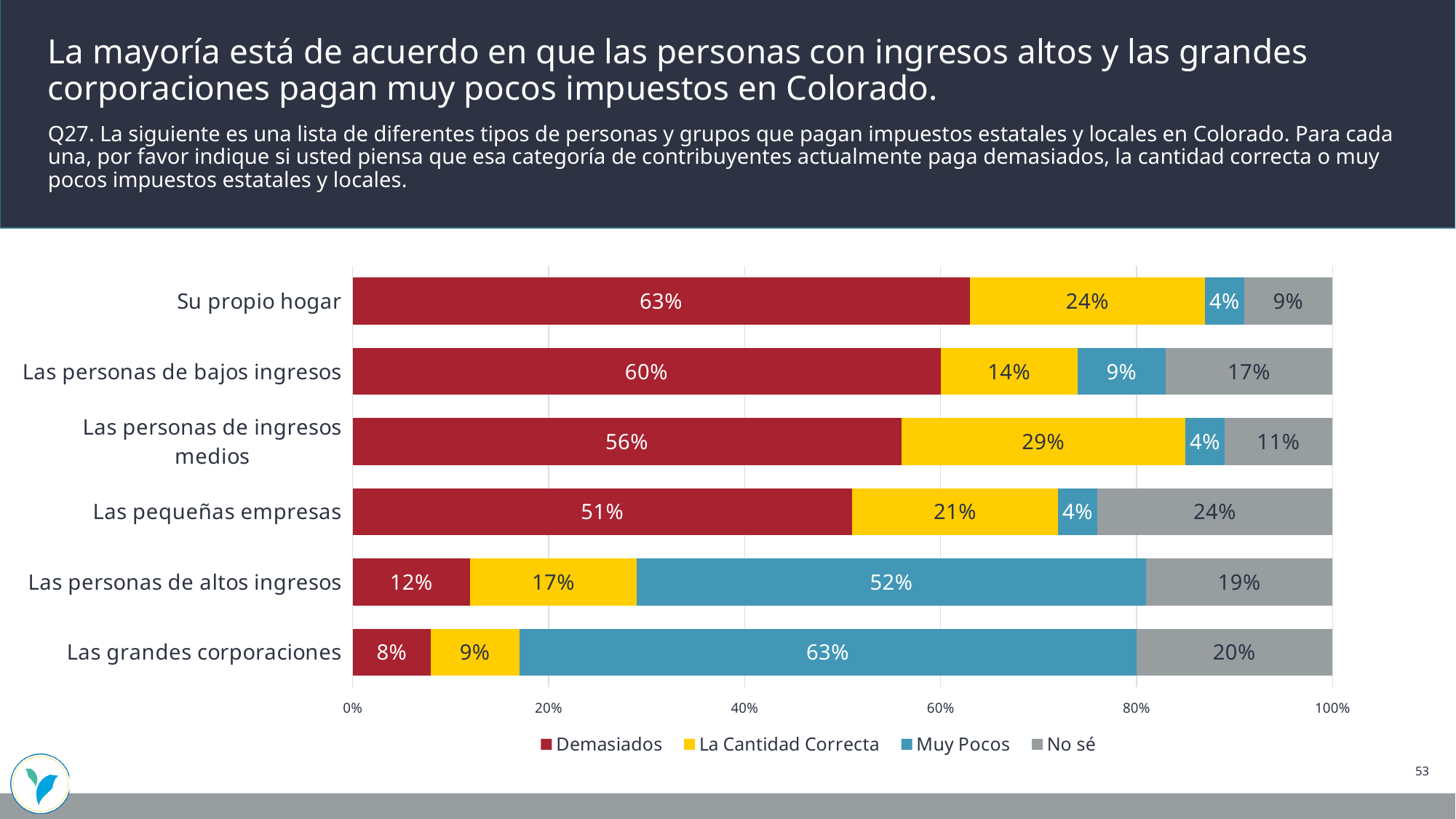
What is the difference between the 'Muy Pocos' values for 'Las grandes corporaciones' and 'Las personas de altos ingresos'? 11% What kind of chart is shown on the slide? Stacked bar chart What is the 'La Cantidad Correcta' value for 'Las personas de ingresos medios'? 29% What percentage of respondents said 'Las grandes corporaciones' pay 'Muy Pocos' taxes? 63% Which category has the lowest 'Demasiados' value? Las grandes corporaciones How many series does the legend list? 4 What is the 'Demasiados' value for 'Las personas de bajos ingresos'? 60% How many categories are shown on the chart? 6 Which category has the highest 'Muy Pocos' value? Las grandes corporaciones Which is larger: the 'Demasiados' value for 'Su propio hogar' or for 'Las pequeñas empresas'? Su propio hogar What is the 'No sé' value for 'Las pequeñas empresas'? 24% What is the total of the 'Demasiados' and 'La Cantidad Correcta' values for 'Las personas de altos ingresos'? 29%